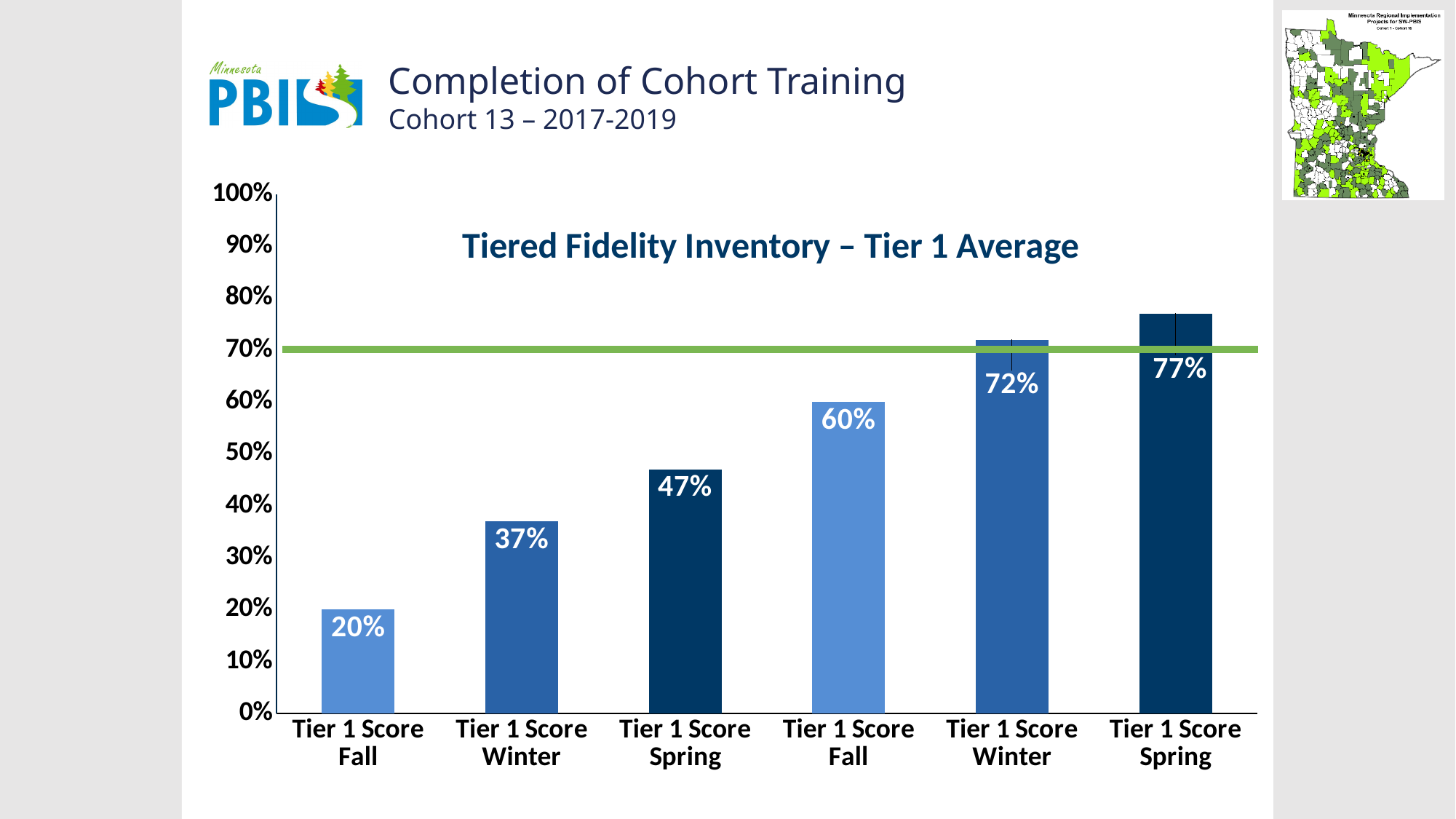
What is the value of the last bar, the second Tier 1 Score Spring bar? 77% Do the bar values rise or fall from left to right across the chart? rise Which bar has the lowest value? Tier 1 Score Fall (the first bar, 20%) Which is larger, the second Tier 1 Score Winter bar or the second Tier 1 Score Fall bar? Tier 1 Score Winter (72%) What is the title of the chart? Tiered Fidelity Inventory – Tier 1 Average Which bar has the highest value? Tier 1 Score Spring (the last bar, 77%) What is the value of the second Tier 1 Score Fall bar (fourth bar from the left)? 60% What type of chart is shown on the slide? bar chart How many bars are plotted in the chart? 6 What is the difference between the last Tier 1 Score Spring bar (77%) and the first Tier 1 Score Spring bar (47%)? 30% What is the value of the first bar, labelled Tier 1 Score Fall? 20% What is the value of the first Tier 1 Score Winter bar (second bar from the left)? 37%